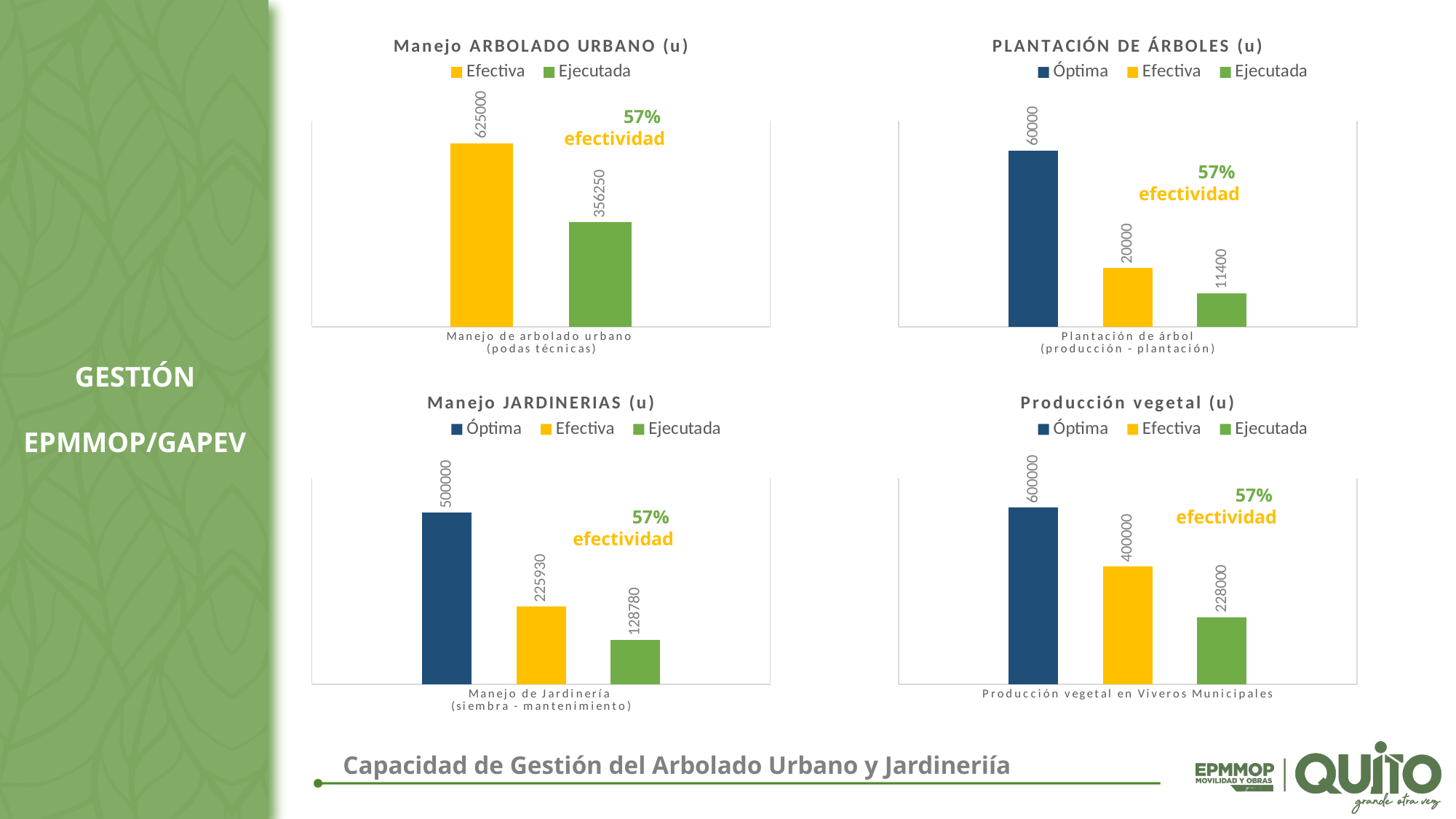
In the 'Producción vegetal (u)' chart, which series has the highest value? Óptima What type of chart is the 'Producción vegetal (u)' chart? Bar chart In the 'PLANTACIÓN DE ÁRBOLES (u)' chart, what is the value of the Óptima bar? 60000 In the 'Manejo ARBOLADO URBANO (u)' chart, what is the value of the Ejecutada bar? 356250 In the 'Manejo ARBOLADO URBANO (u)' chart, what is the value of the Efectiva bar? 625000 In the 'PLANTACIÓN DE ÁRBOLES (u)' chart, which series has the lowest value? Ejecutada In the 'Manejo JARDINERIAS (u)' chart, what is the value of the Efectiva bar? 225930 In the 'Producción vegetal (u)' chart, what is the value of the Ejecutada bar? 228000 In the 'Manejo JARDINERIAS (u)' chart, what is the difference between the Óptima and Efectiva values? 274070 How many series does the legend of the 'Manejo ARBOLADO URBANO (u)' chart list? 2 In the 'Manejo ARBOLADO URBANO (u)' chart, what is the difference between the Efectiva and Ejecutada values? 268750 In the 'PLANTACIÓN DE ÁRBOLES (u)' chart, what is the value of the Ejecutada bar? 11400